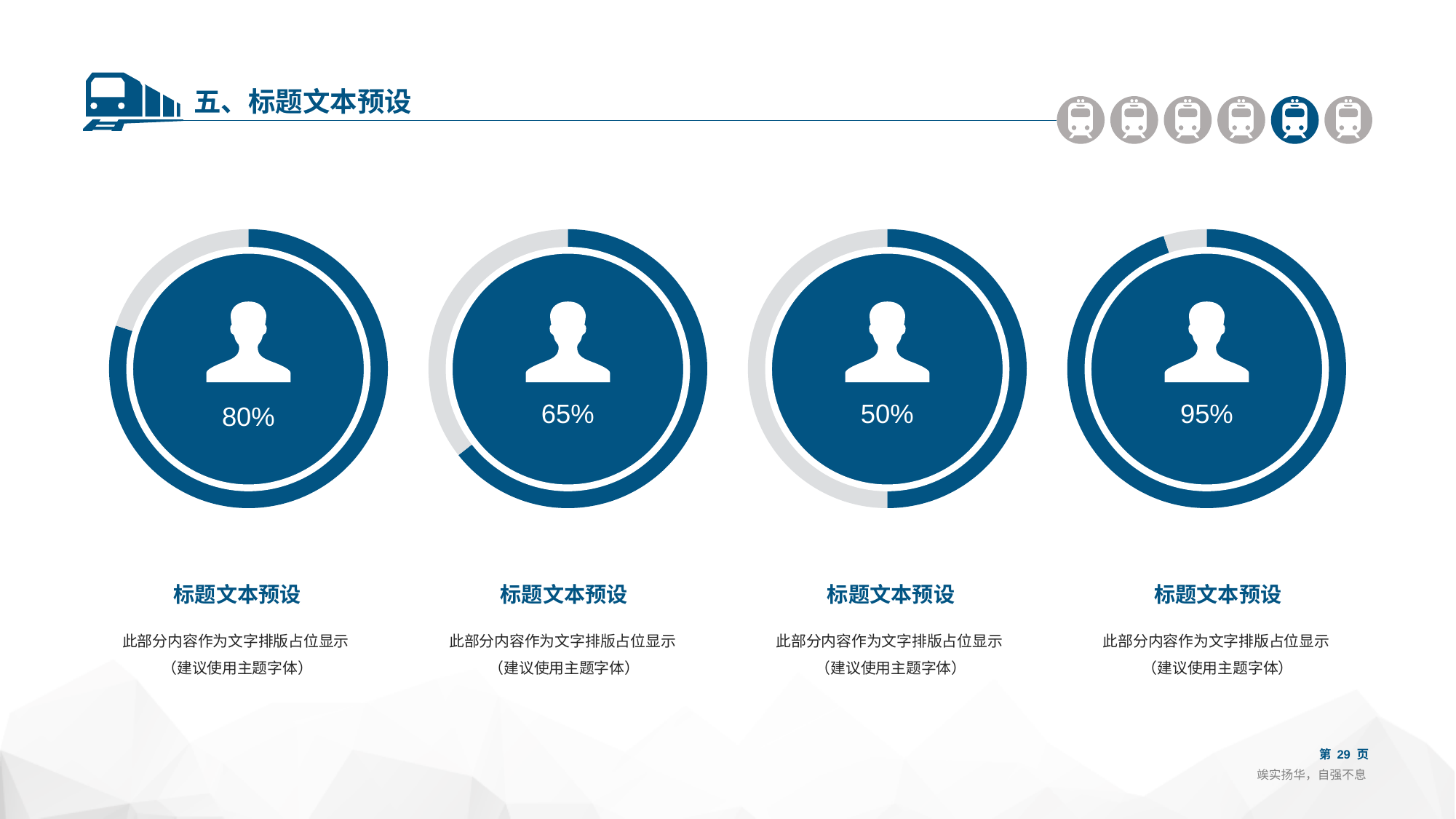
What value is shown in the first (leftmost) ring chart? 80% What value is shown in the third ring chart from the left? 50% What value is shown in the second ring chart from the left? 65% What is the difference between the value in the rightmost ring chart and the value in the leftmost ring chart? 15% What kind of chart is used to display each percentage on the slide? Ring (donut) progress chart What is the difference between the values in the second and third ring charts from the left? 15% Which ring chart shows the highest percentage? The fourth (rightmost), 95% What colour is the filled portion of each ring chart? Dark blue How many ring charts are shown on the slide? 4 What value is shown in the fourth (rightmost) ring chart? 95% Which is larger, the value in the first ring chart or the value in the second ring chart? The first ring chart (80%) Which ring chart shows the lowest percentage? The third from the left, 50%